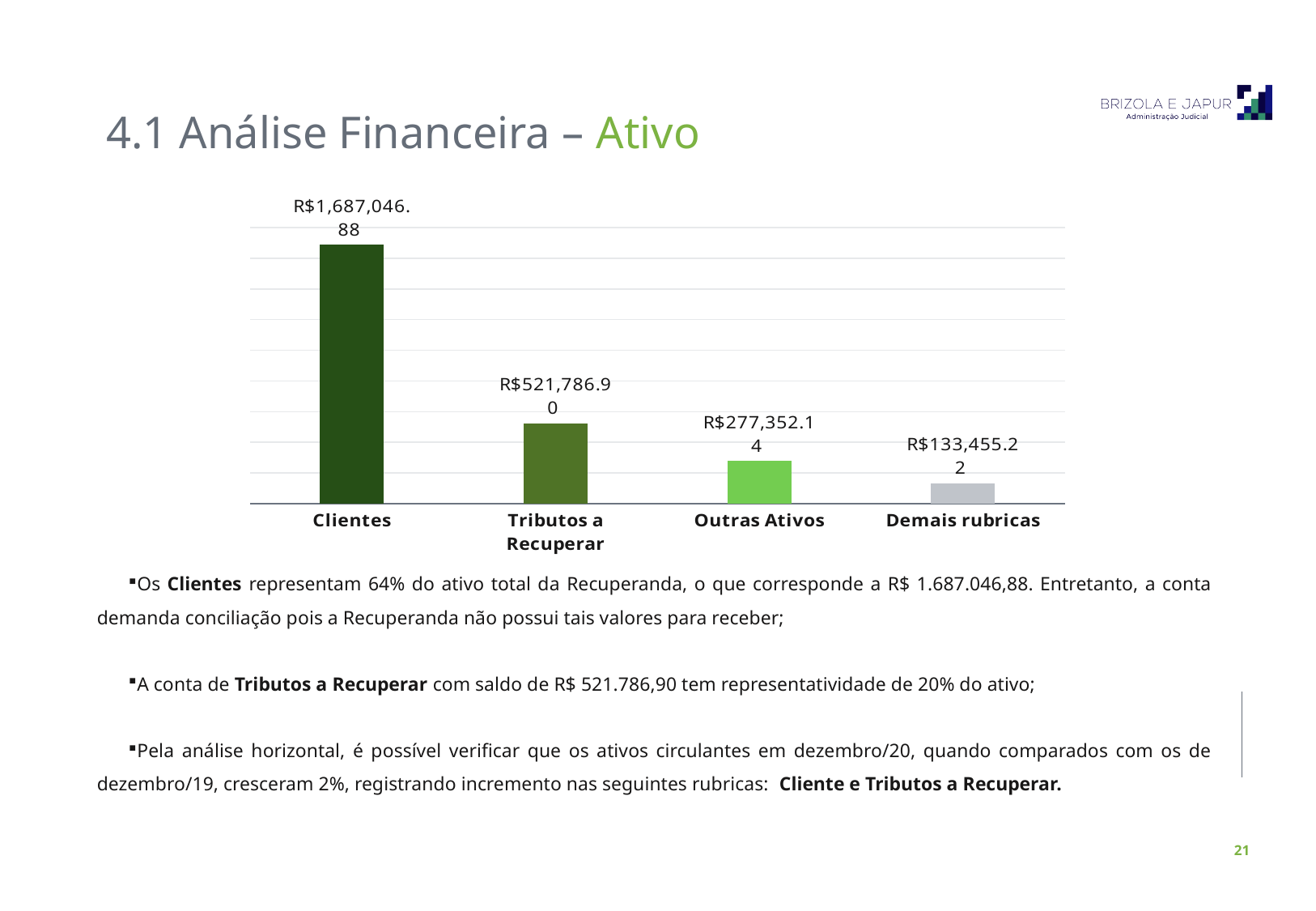
Which is larger, the value for Tributos a Recuperar or the value for Outras Ativos? Tributos a Recuperar How many categories are shown in the chart? 4 What is the difference between the values for Clientes and Tributos a Recuperar? R$1,165,259.98 Which category has the lowest value? Demais rubricas What is the difference between the values for Outras Ativos and Demais rubricas? R$143,896.92 What is the value shown for Outras Ativos? R$277,352.14 What is the value shown for Tributos a Recuperar? R$521,786.90 What is the value shown for Demais rubricas? R$133,455.22 What is the value shown for Clientes? R$1,687,046.88 What kind of chart is shown on the slide? Bar chart Do the values rise or fall from left to right across the categories? Fall Which category has the highest value? Clientes